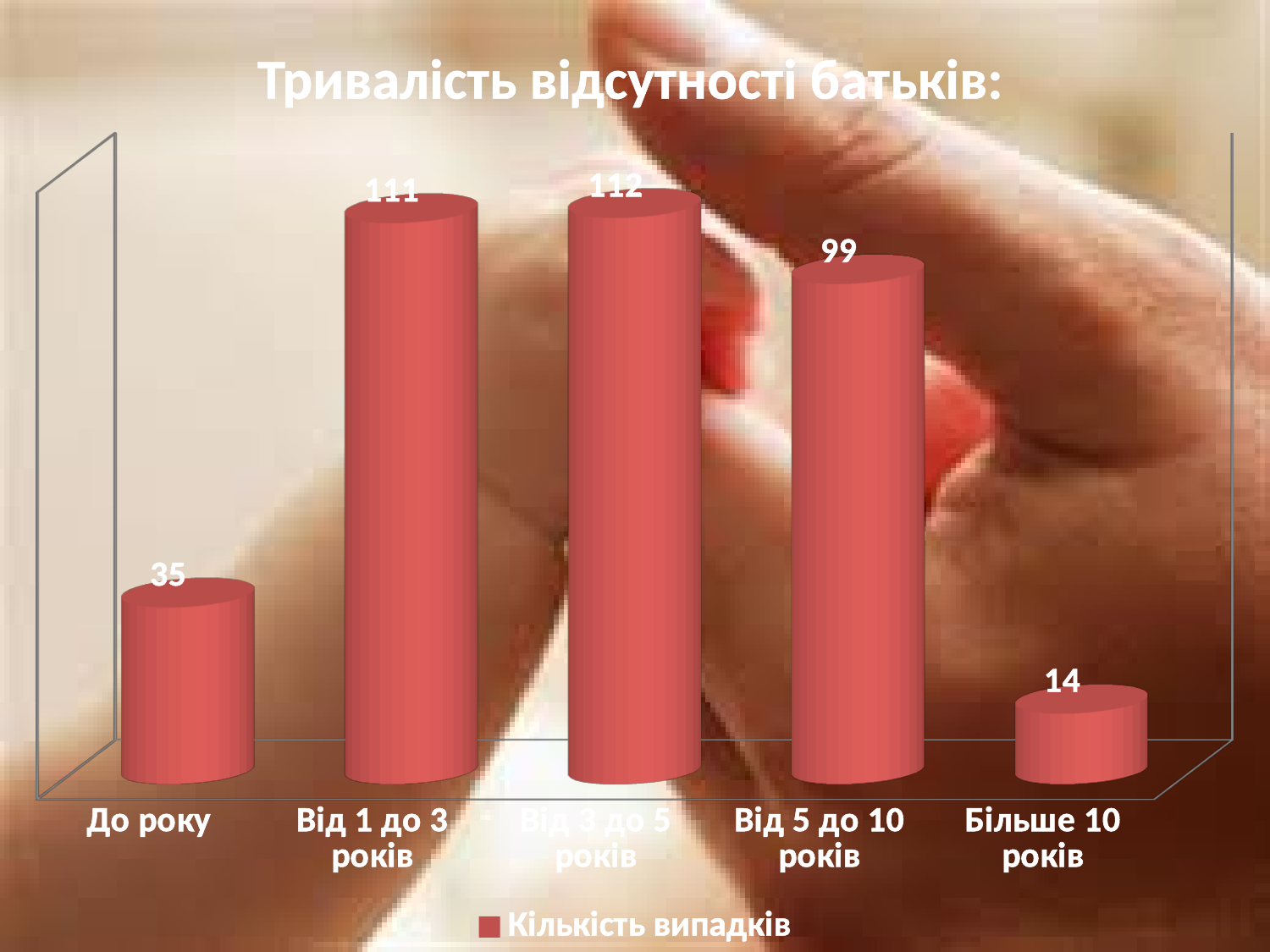
Which category has the highest value? Від 3 до 5 років What kind of chart is shown on the slide? Bar chart What is the difference between the values for "Від 5 до 10 років" and "Більше 10 років"? 85 What is the value for "Від 5 до 10 років"? 99 How many categories are shown in the chart? 5 What is the difference between the values for "Від 1 до 3 років" and "До року"? 76 What is the value for "До року"? 35 Which category has the lowest value? Більше 10 років Which is larger, the value for "До року" or the value for "Від 5 до 10 років"? Від 5 до 10 років What is the series name shown in the legend? Кількість випадків What is the value for "Від 3 до 5 років"? 112 What is the value for "Більше 10 років"? 14